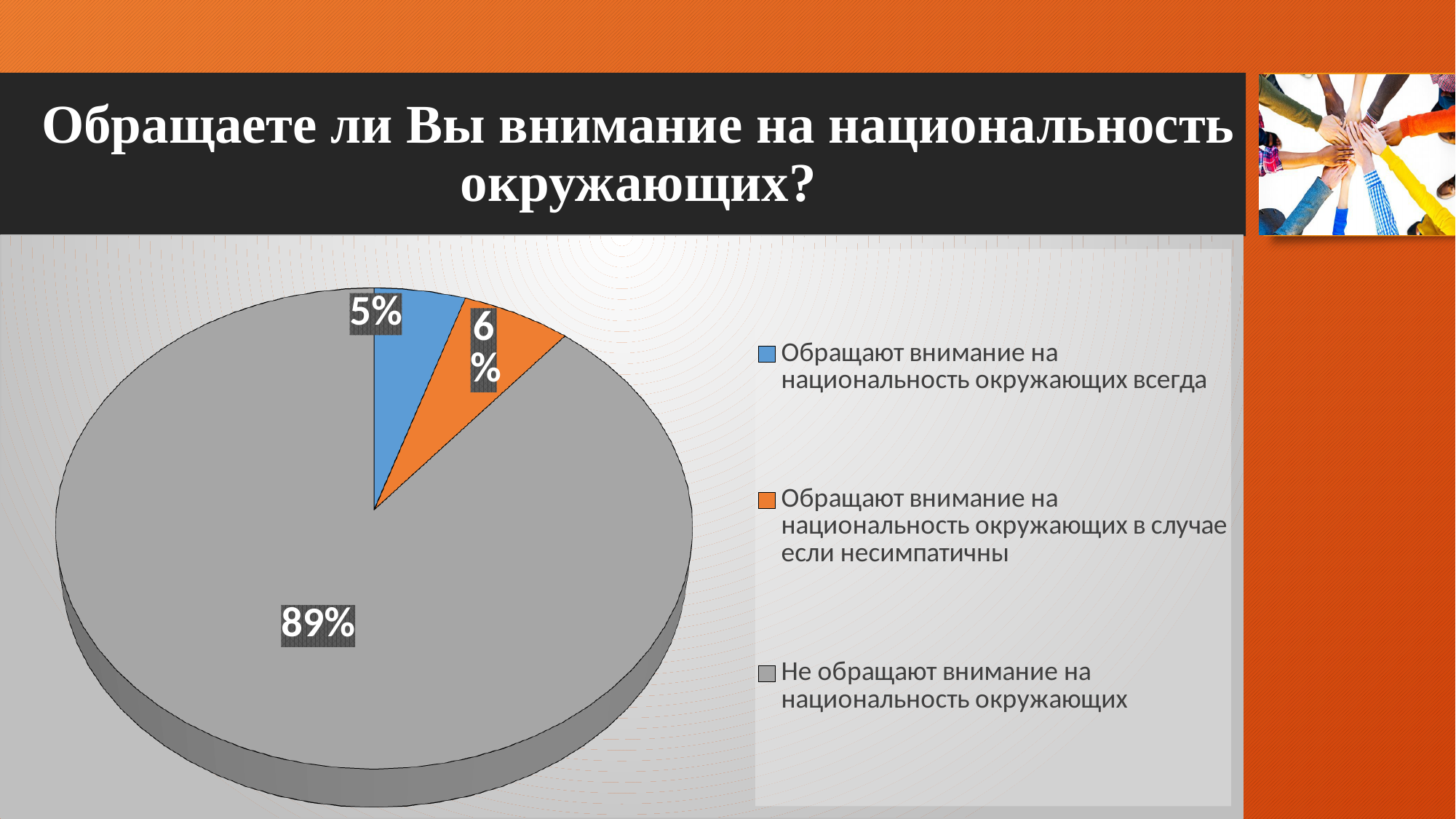
What kind of chart is shown on the slide? Pie chart What is the title of the slide containing the pie chart? Обращаете ли Вы внимание на национальность окружающих? What share of respondents do not pay attention to the nationality of those around them (Не обращают внимание на национальность окружающих)? 89% What share of respondents pay attention to nationality only if the people are unpleasant (в случае если несимпатичны)? 6% How many categories does the pie chart show? 3 Which category has the largest slice of the pie? Не обращают внимание на национальность окружающих Which is larger: the share that always pay attention to nationality or the share that pay attention only if the people are unpleasant? Обращают внимание на национальность окружающих в случае если несимпатичны What colour is the slice for 'Не обращают внимание на национальность окружающих'? Grey What share of respondents always pay attention to the nationality of those around them (Обращают внимание на национальность окружающих всегда)? 5% Which category has the smallest slice of the pie? Обращают внимание на национальность окружающих всегда What is the difference between the share that do not pay attention to nationality and the share that always pay attention? 84% What is the combined share of respondents who pay attention to nationality either always or only if the people are unpleasant? 11%